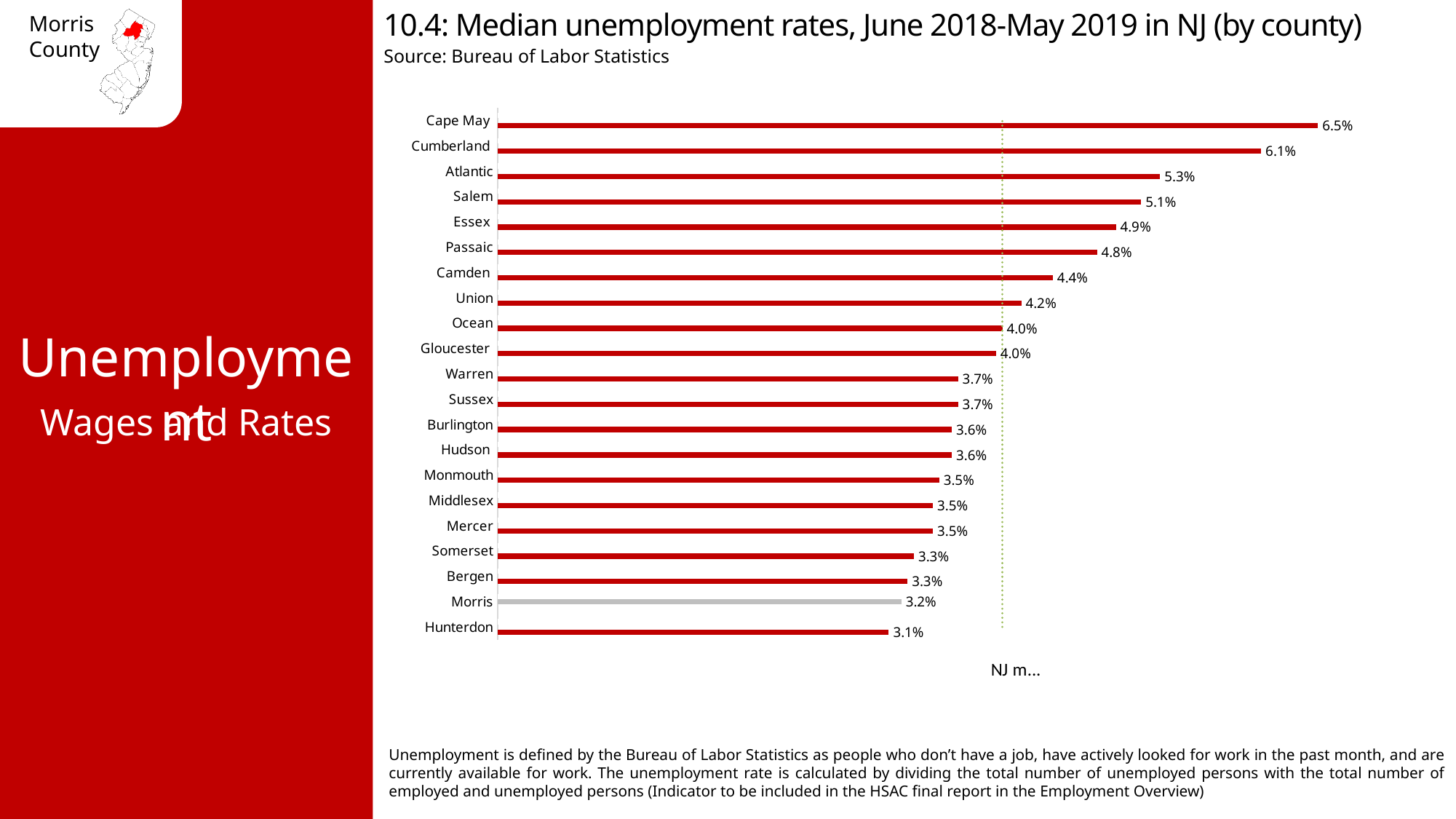
What is the difference between the median unemployment rates of Essex and Morris? 1.7 percentage points Which county has a higher median unemployment rate, Passaic or Somerset? Passaic What is the median unemployment rate for Camden County? 4.4% What is the median unemployment rate for Morris County? 3.2% What type of chart is used to show the median unemployment rates? Bar chart Which county has a higher median unemployment rate, Atlantic or Union? Atlantic What is the difference between the median unemployment rates of Cape May and Hunterdon? 3.4 percentage points How many counties are shown in the chart? 21 Which county's bar is shown in grey instead of red? Morris Which county has the highest median unemployment rate? Cape May What is the median unemployment rate for Cumberland County? 6.1% Which county has the lowest median unemployment rate? Hunterdon